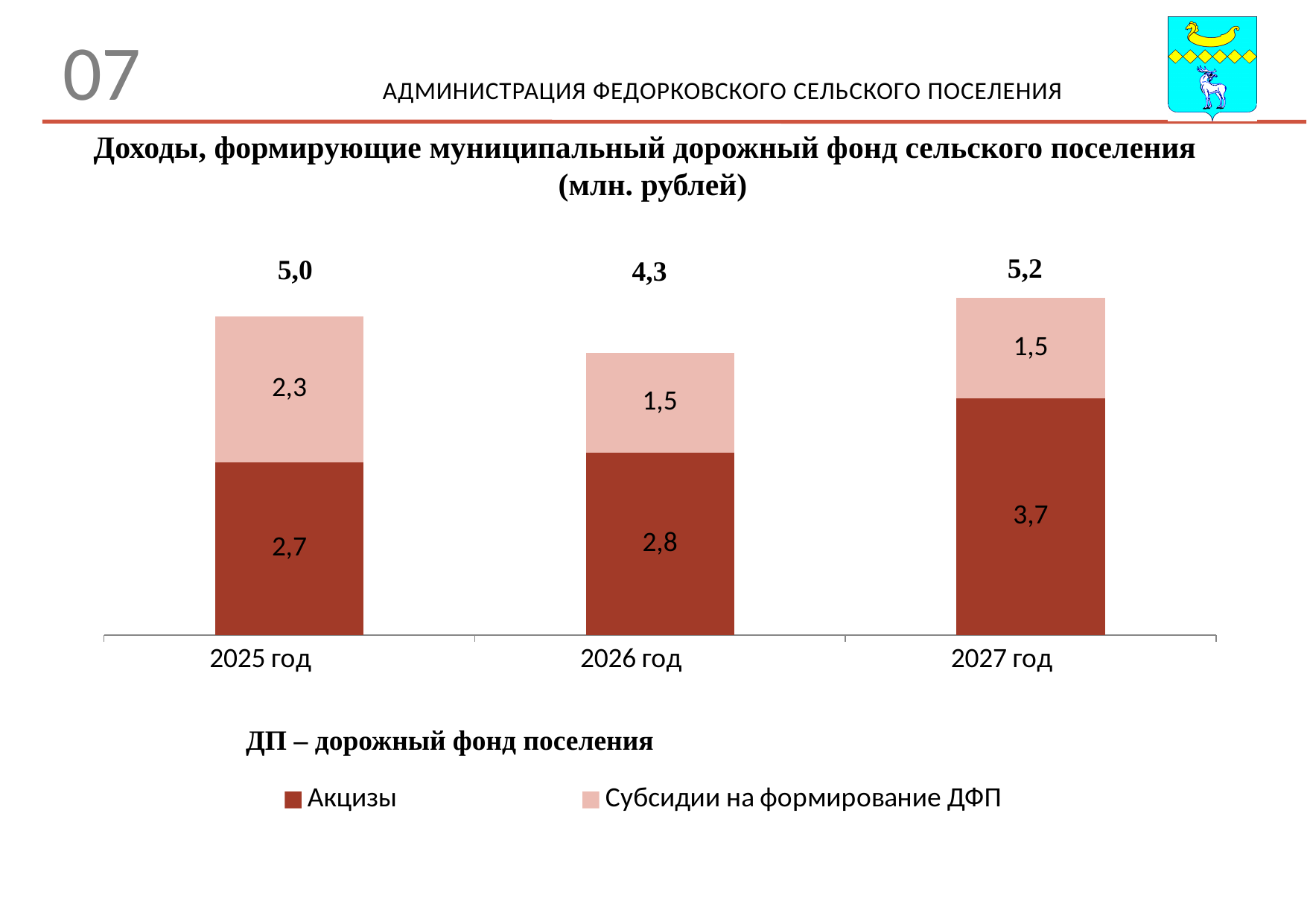
Which year has the highest value for Субсидии на формирование ДФП? 2025 год What is the total of the stacked bar for 2026 год? 4,3 Is Акцизы larger in 2027 год or in 2026 год? 2027 год What is the value of Акцизы for 2025 год? 2,7 What is the difference between Акцизы in 2027 год and Акцизы in 2025 год? 1,0 What is the value of Акцизы for 2027 год? 3,7 What kind of chart is shown? Stacked bar chart How many years are shown on the x axis? 3 Which year has the lowest total? 2026 год What is the value of Субсидии на формирование ДФП for 2027 год? 1,5 Which year has the highest total? 2027 год How many series does the legend list? 2